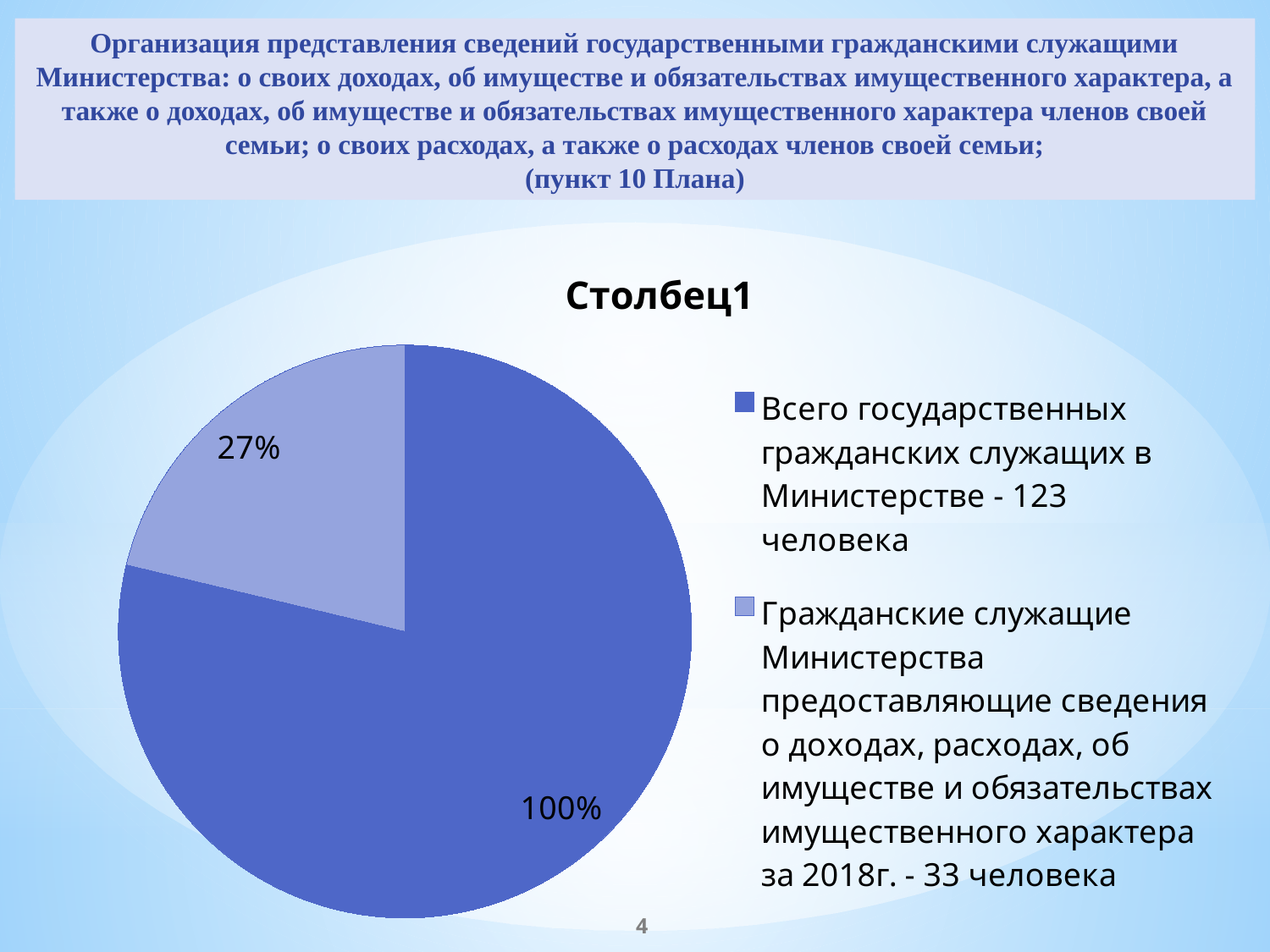
What kind of chart is shown on the slide? pie chart What data label is shown on the slice for "Гражданские служащие Министерства предоставляющие сведения о доходах, расходах, об имуществе и обязательствах имущественного характера за 2018г. - 33 человека"? 27% What colour is the slice labelled 27%? light blue Which slice is larger: the one labelled 100% or the one labelled 27%? the one labelled 100% What is the title of the chart? Столбец1 Which legend entry corresponds to the smallest slice of the pie? Гражданские служащие Министерства предоставляющие сведения о доходах, расходах, об имуществе и обязательствах имущественного характера за 2018г. - 33 человека Which legend entry corresponds to the largest slice of the pie? Всего государственных гражданских служащих в Министерстве - 123 человека What data label is shown on the slice for "Всего государственных гражданских служащих в Министерстве - 123 человека"? 100% How many slices does the pie chart have? 2 How many people does the legend give for the total number of state civil servants in the Ministry? 123 человека How many people does the legend give for civil servants who submitted information for 2018? 33 человека How many entries does the legend list? 2